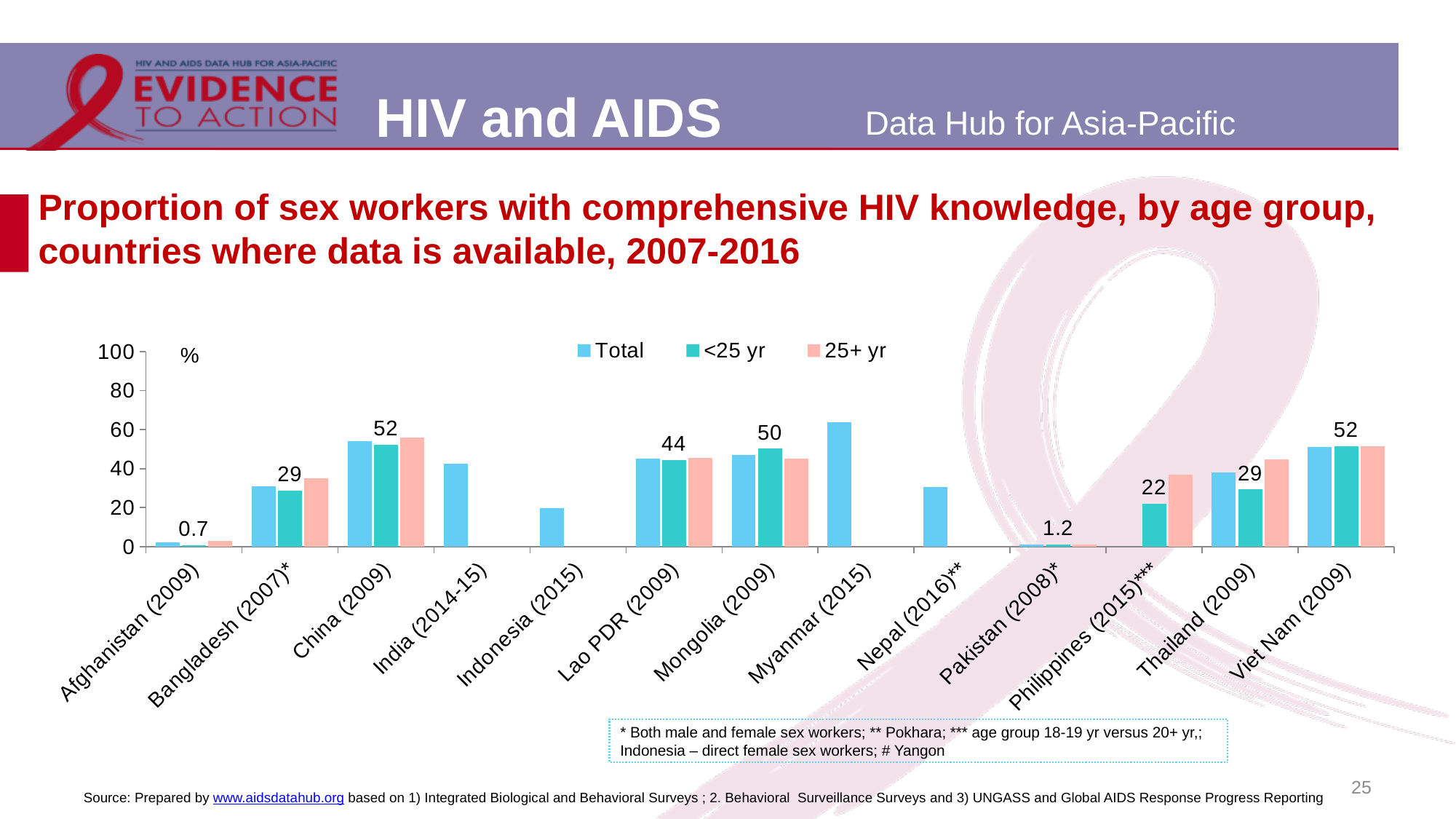
What is the value for the <25 yr series for China (2009)? 52 Is the Total value for Myanmar (2015) greater or less than 60? greater How many countries are shown on the x axis? 13 Which has the larger <25 yr value, Mongolia (2009) or Lao PDR (2009)? Mongolia (2009) What is the difference between the <25 yr values for China (2009) and Bangladesh (2007)*? 23 Is the Total value for Nepal (2016)** greater or less than 40? less What is the value for the <25 yr series for Philippines (2015)***? 22 What is the value for the <25 yr series for Lao PDR (2009)? 44 How many series does the legend list? 3 What kind of chart is shown on the slide? Bar chart Which country has the lowest <25 yr value? Afghanistan (2009) What is the value for the <25 yr series for Afghanistan (2009)? 0.7